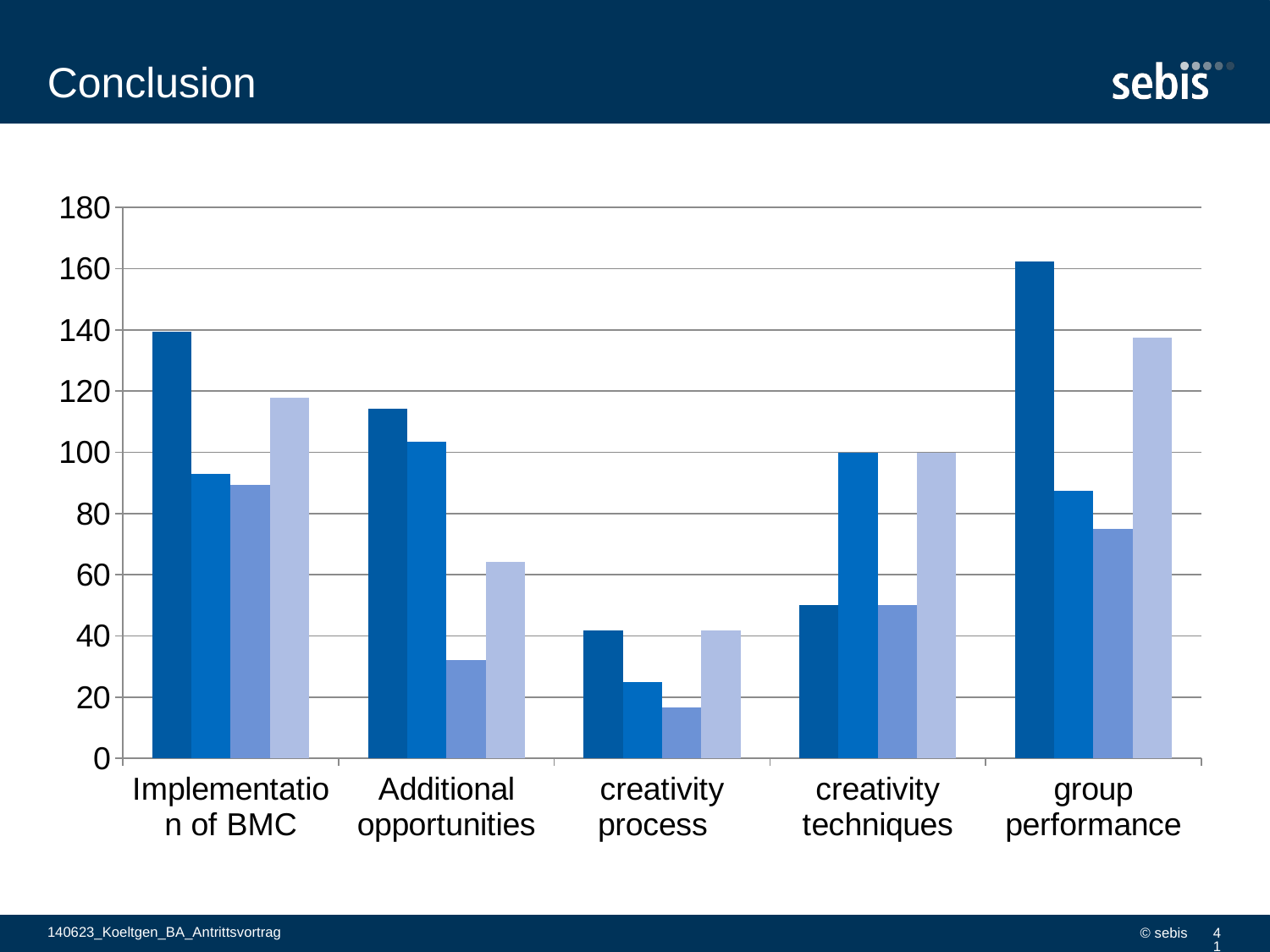
Among the darkest blue (first) bars, which category has the highest value? group performance Is the lightest blue (fourth) bar for group performance greater or less than 120? greater Among the darkest blue (first) bars, which category has the lowest value? creativity process Is the darkest blue (first) bar for creativity process greater or less than 60? less Which has the larger darkest blue (first) bar: Implementation of BMC or Additional opportunities? Implementation of BMC Does the chart include a legend identifying the bar series? No Is the darkest blue (first) bar for group performance greater or less than 140? greater Which has the larger lightest blue (fourth) bar: creativity techniques or group performance? group performance What kind of chart is shown on the slide? bar chart How many bars are plotted for each category in the chart? 4 How many categories are shown on the x axis of the chart? 5